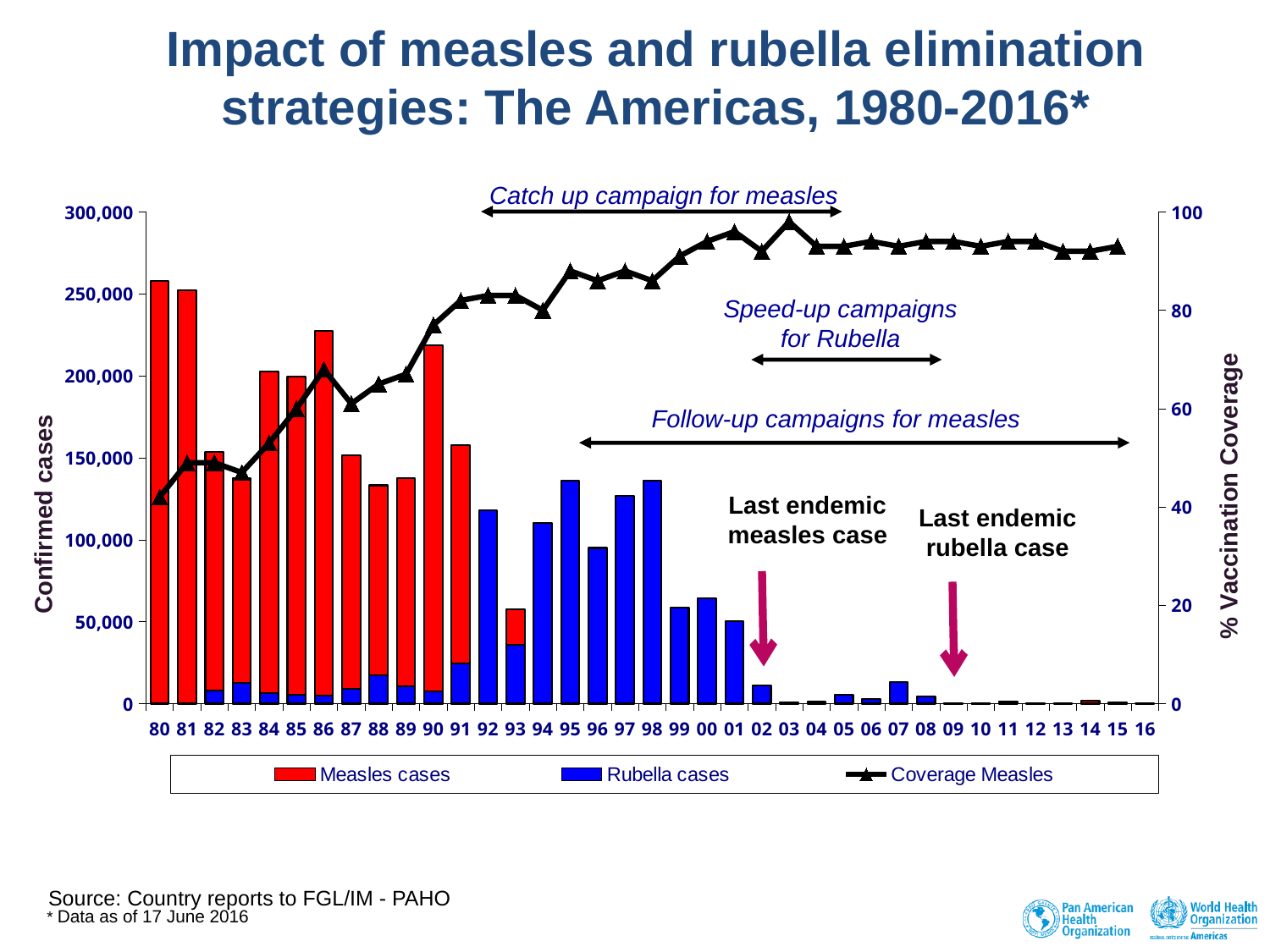
Is the Measles cases value for 80 greater or less than 200,000? greater How many years are shown along the x axis? 37 Is the Coverage Measles value for 03 greater or less than 90? greater Is the Coverage Measles value for 80 greater or less than 50? less Which year has the lowest Coverage Measles value? 80 What is the label of the right-hand vertical axis? % Vaccination Coverage What kind of chart is shown on the slide? A combination bar and line chart Which is larger, the Rubella cases value for 96 or for 99? 96 How many series does the legend list? 3 Does the Coverage Measles line generally rise or fall from 80 to 00? rise Which is larger, the Measles cases value for 80 or for 91? 80